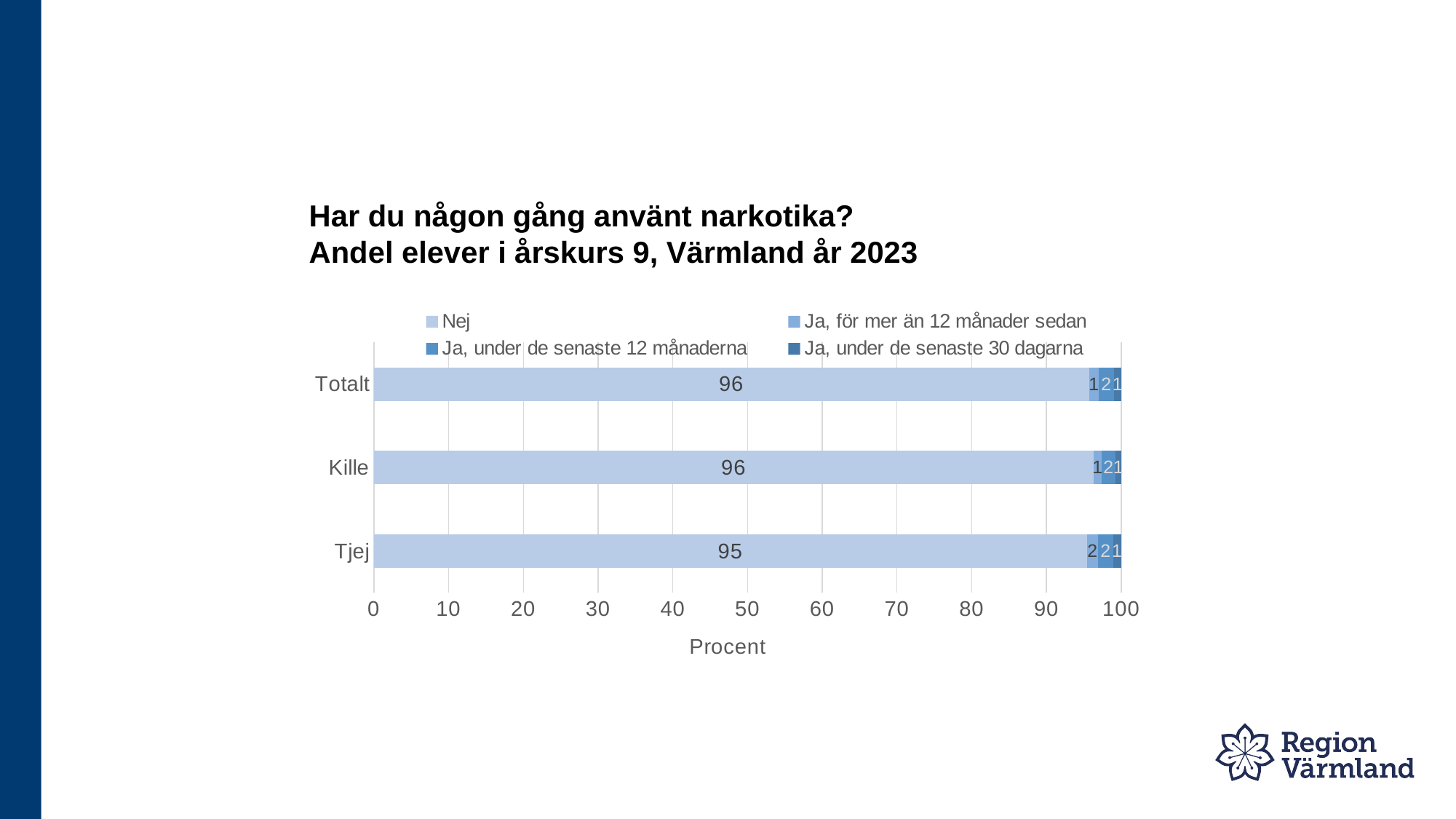
Which is larger, the "Nej" value for Totalt or for Tjej? Totalt What is the value of "Ja, under de senaste 12 månaderna" for Totalt? 2 What kind of chart is shown on the slide? Stacked bar chart What is the difference between the "Nej" values for Kille and Tjej? 1 What is the value of "Nej" for Tjej? 95 What is the value of "Ja, för mer än 12 månader sedan" for Tjej? 2 Which category has the lowest value for "Nej"? Tjej What is the value of "Nej" for Kille? 96 How many series does the legend list? 4 How many categories are shown on the y axis? 3 What is the value of "Ja, under de senaste 30 dagarna" for Kille? 1 What is the label of the x axis? Procent